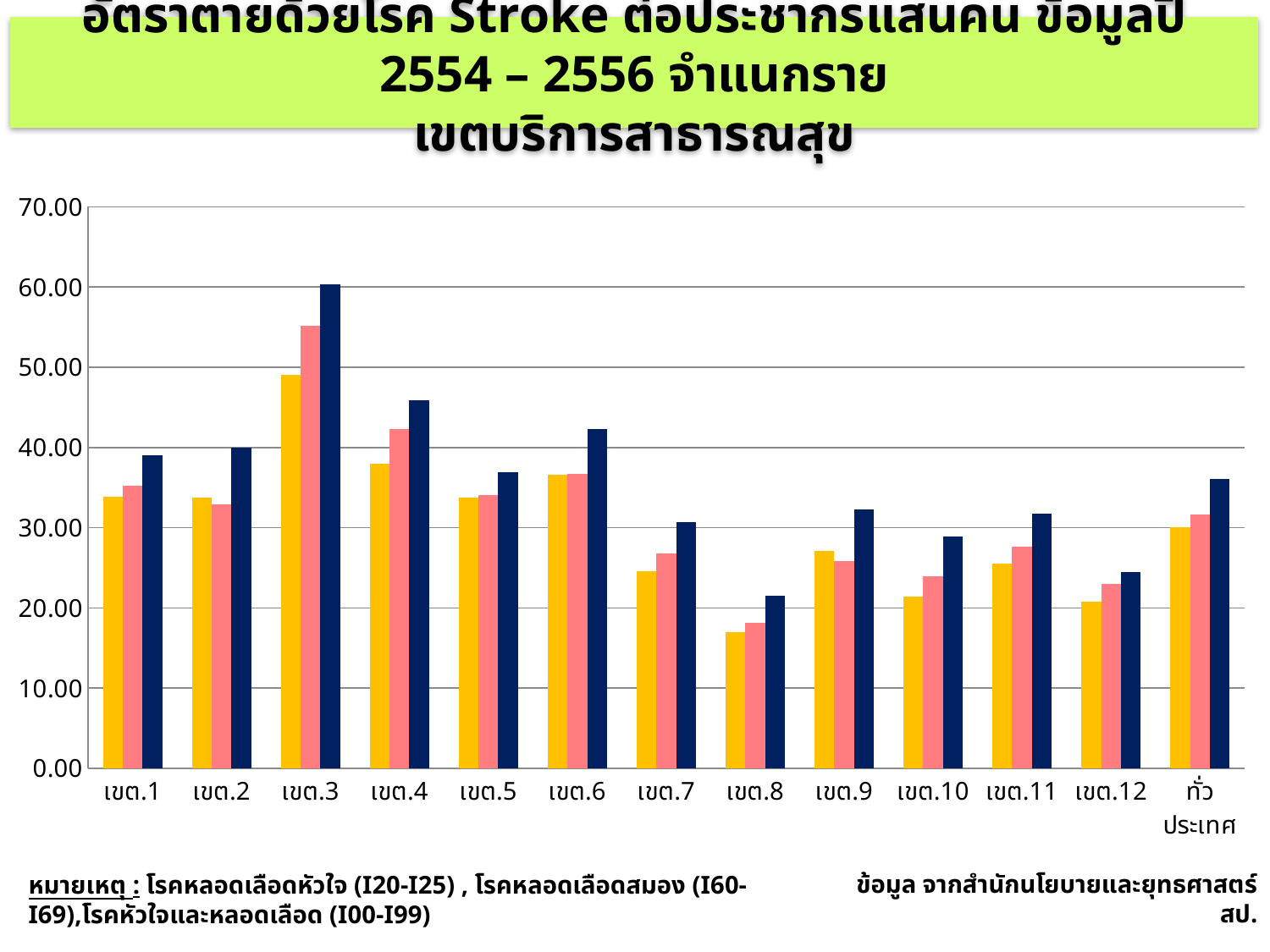
Is the pink bar for เขต.7 greater or less than 30.00? less Is the yellow bar for เขต.4 greater or less than 40.00? less Is the yellow bar for เขต.8 greater or less than 20.00? less What kind of chart is shown on the slide? bar chart How many categories are shown along the x axis of the chart? 13 Is the dark blue bar for เขต.8 taller or shorter than the dark blue bar for เขต.3? shorter Which category has the tallest bar in the chart? เขต.3 Which category has the shortest bar in the chart? เขต.8 What is the highest value shown on the y axis of the chart? 70.00